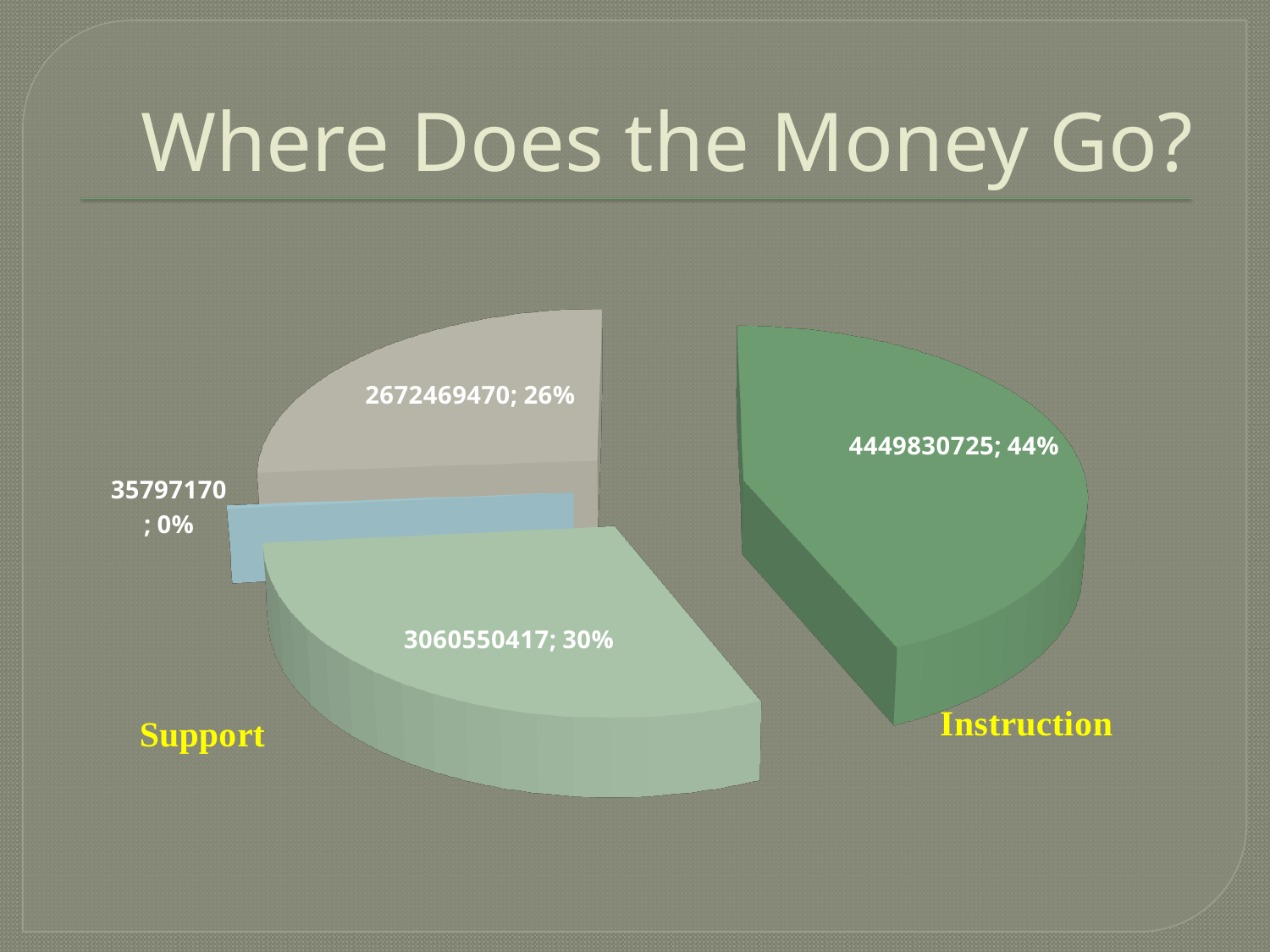
What is the title of the chart on the slide? Where Does the Money Go? What value is shown for the Instruction slice? 4449830725 What share of the pie does Support represent? 30% Which is larger, the Instruction slice or the Support slice? Instruction How many slices does the pie chart have? 4 What share of the pie does Instruction represent? 44% What value is shown for the Support slice? 3060550417 What is the difference between the Instruction value and the Support value? 1389280308 What percentage is shown on the tan-coloured slice at the top of the pie? 26% Which labelled category has the largest slice of the pie? Instruction What kind of chart is shown on the slide? pie chart